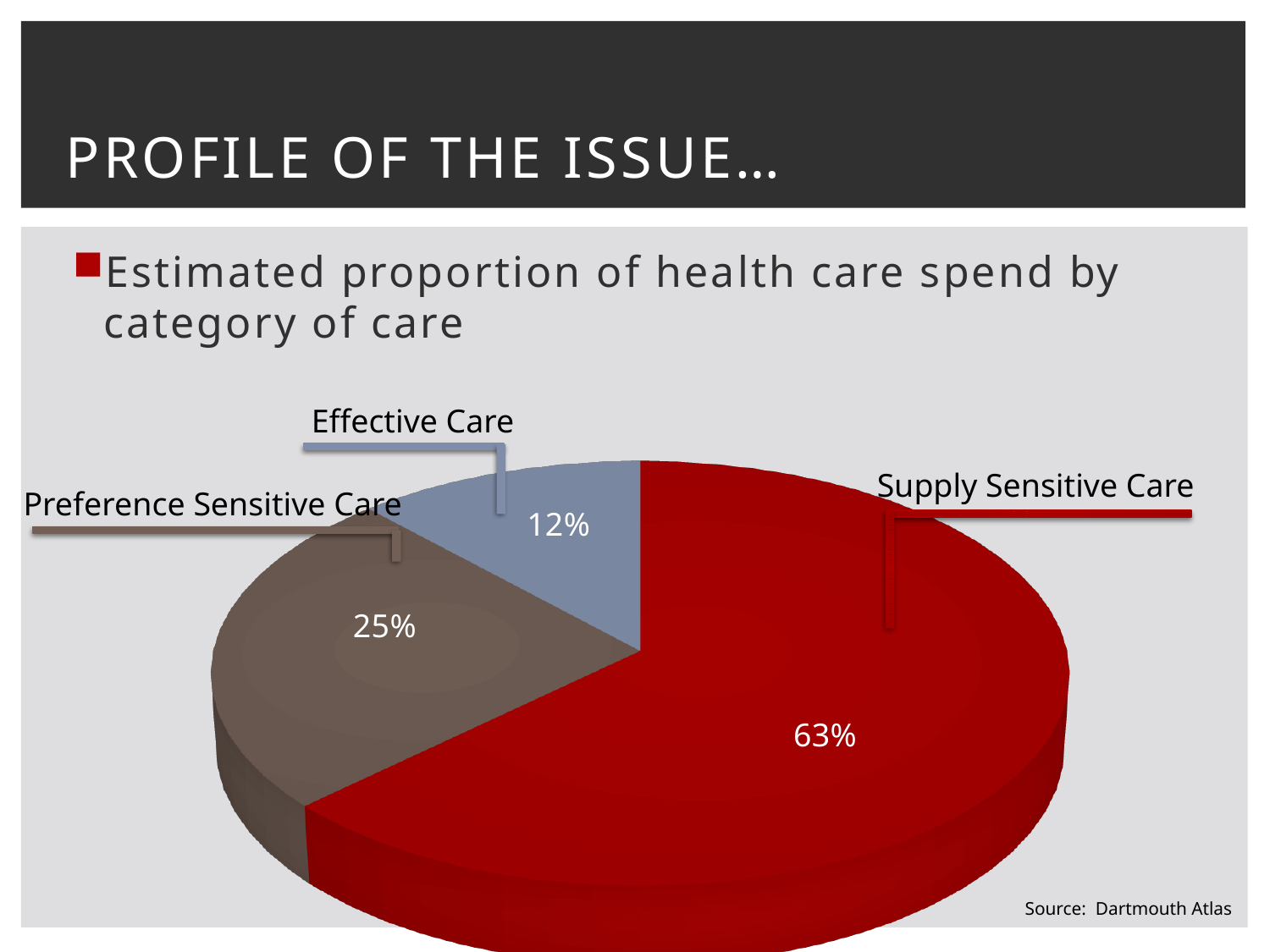
What share of health care spend does Supply Sensitive Care account for? 63% How many categories of care are shown in the pie chart? 3 How many percentage points larger is the Preference Sensitive Care share than the Effective Care share? 13 percentage points What colour is the Supply Sensitive Care slice? Red Which category of care has the largest share of health care spend? Supply Sensitive Care What source is cited for the chart? Dartmouth Atlas Which category of care has the smallest share of health care spend? Effective Care What kind of chart is shown on the slide? Pie chart What share of health care spend does Preference Sensitive Care account for? 25% Which has a larger share of spend, Preference Sensitive Care or Effective Care? Preference Sensitive Care What share of health care spend does Effective Care account for? 12% How many percentage points larger is the Supply Sensitive Care share than the Preference Sensitive Care share? 38 percentage points